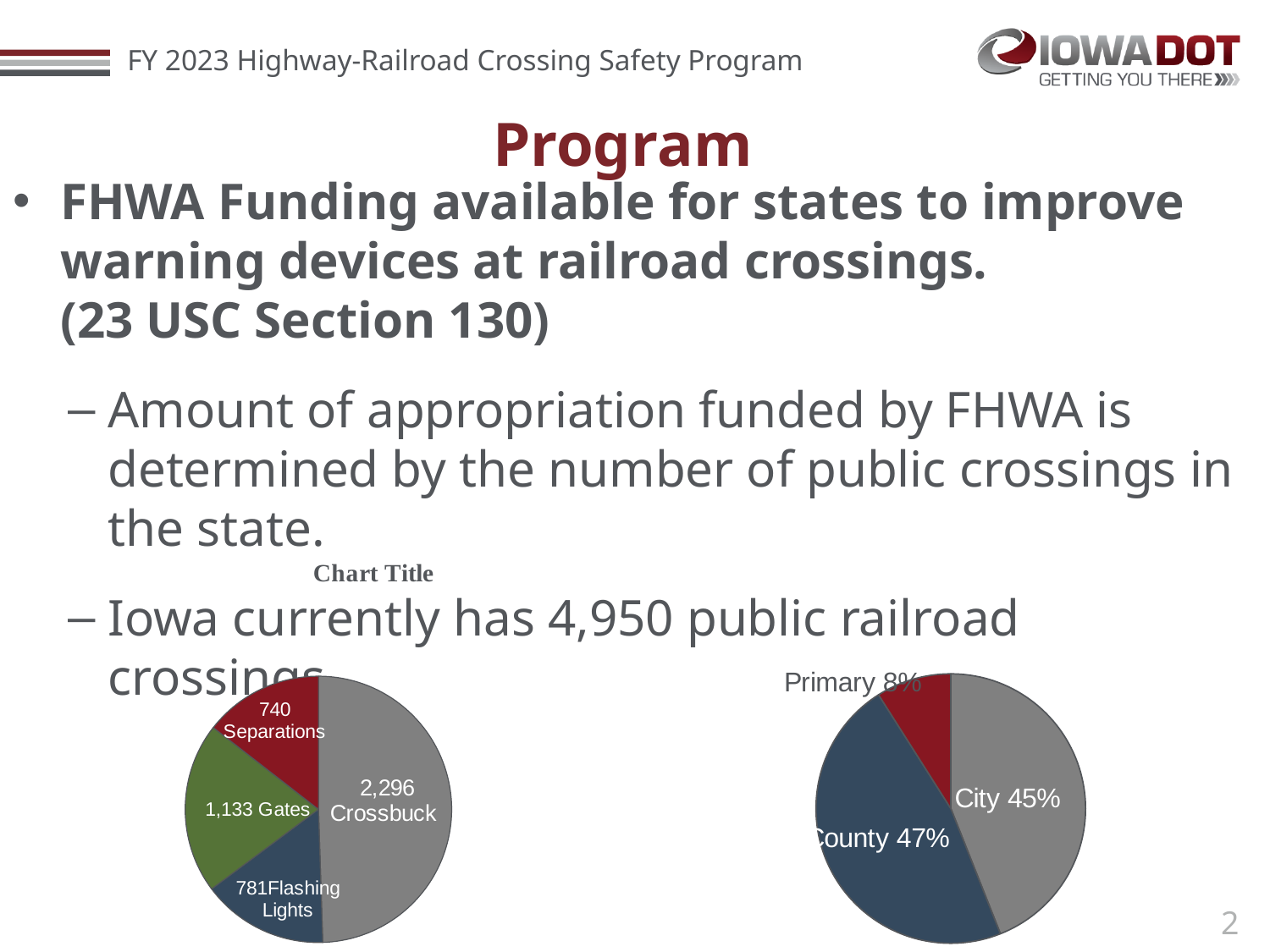
In the left pie chart, how many Crossbuck crossings are shown? 2,296 What type of chart is the right chart on the slide? pie chart In the left pie chart, what is the difference between the Crossbuck value and the Gates value? 1,163 In the left pie chart, what is the value for Flashing Lights? 781 In the right pie chart, what share is labelled County? 47% In the left pie chart, which is larger, Gates or Flashing Lights? Gates In the right pie chart, what share is labelled Primary? 8% In the left pie chart, what is the value for Separations? 740 In the left pie chart, which category has the smallest value? Separations How many slices does the left pie chart have? 4 In the left pie chart, which category has the largest slice? Crossbuck In the left pie chart, what is the value for Gates? 1,133